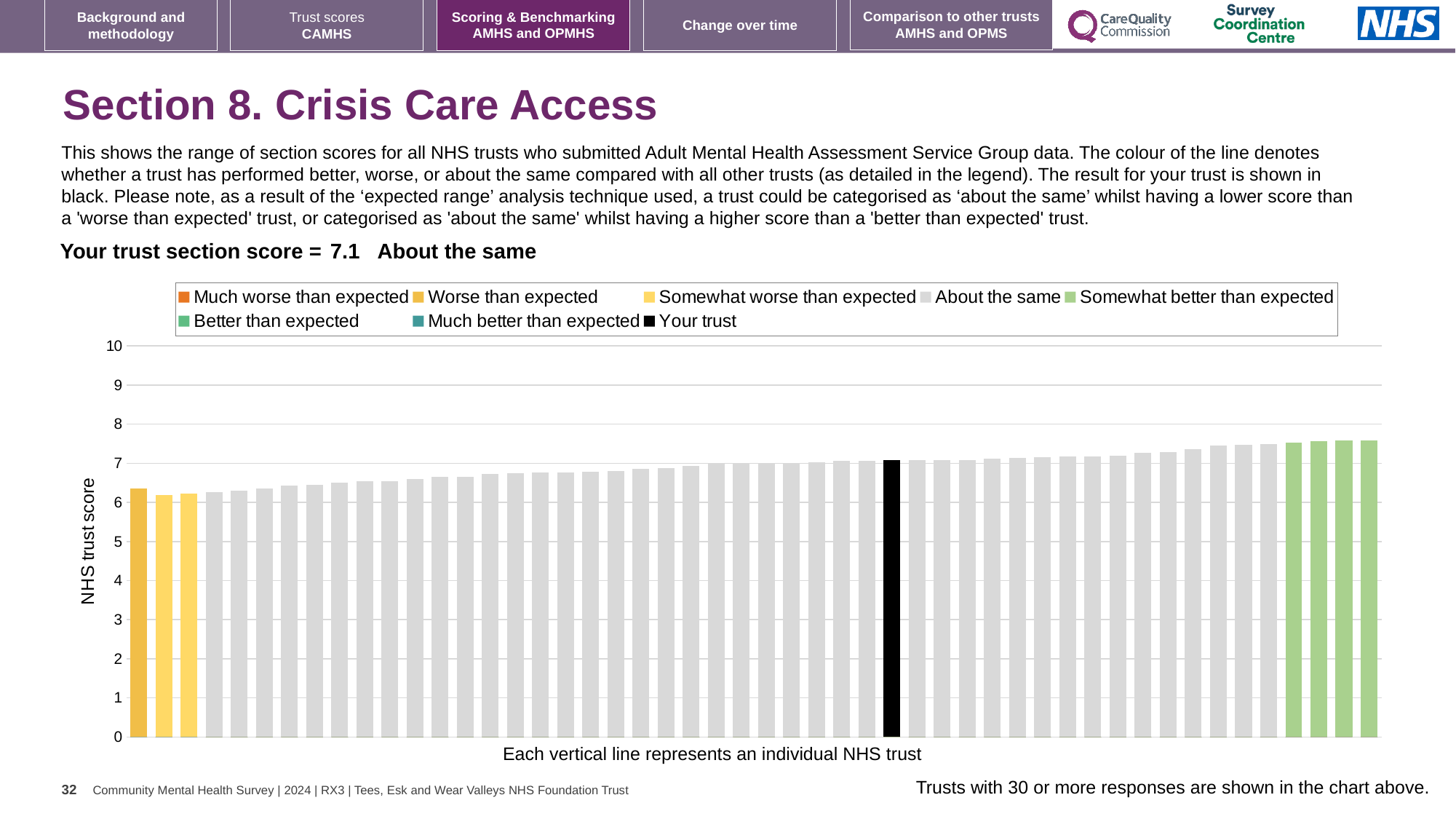
What colour is the bar representing your trust? black Is the value for your trust (the black bar) greater or less than 5? greater Do the bar values rise or fall from left to right along the x axis? rise What is the highest value shown on the y axis? 10 How many entries does the chart legend list? 8 How many bars are coloured green (somewhat better than expected)? 4 What is the label on the y axis of the chart? NHS trust score What is the section score for your trust shown on the slide? 7.1 Is the value for the shortest bar in the chart greater or less than 6? greater What kind of chart is shown on the slide? bar chart Is the value for the tallest bar in the chart greater or less than 8? less Which category is your trust placed in for this section? About the same